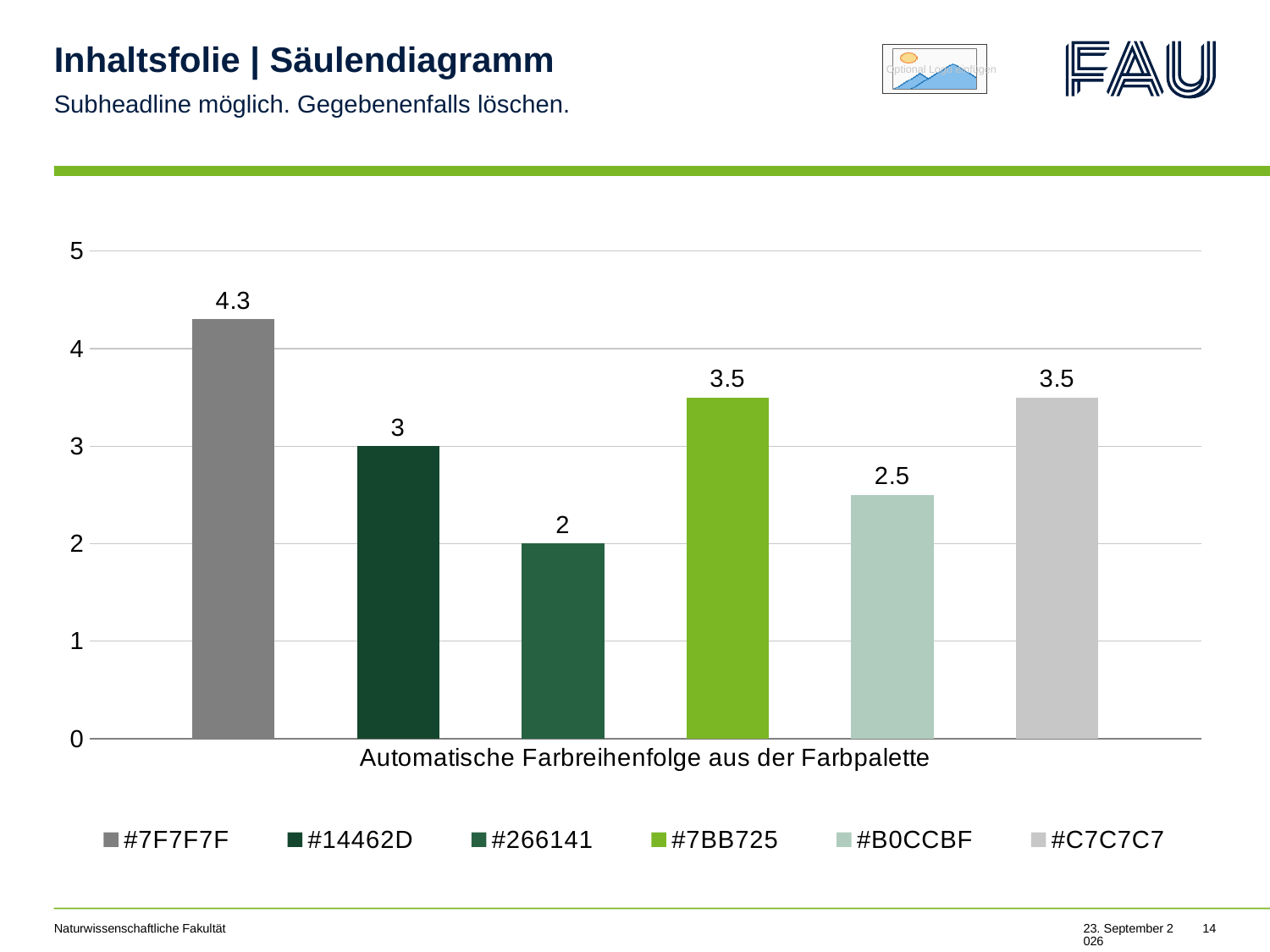
What is the difference between the values for #7F7F7F and #14462D? 1.3 Is the value for #C7C7C7 greater or less than 3? greater How many series does the legend list? 6 Which series has the highest value? #7F7F7F Which is larger, the value for #7BB725 or the value for #B0CCBF? #7BB725 What kind of chart is shown on the slide? bar chart What is the value for the #266141 series? 2 What is the category label shown on the x axis? Automatische Farbreihenfolge aus der Farbpalette What is the value for the #7F7F7F series? 4.3 What is the value for the #14462D series? 3 What is the value for the #B0CCBF series? 2.5 Which series has the lowest value? #266141